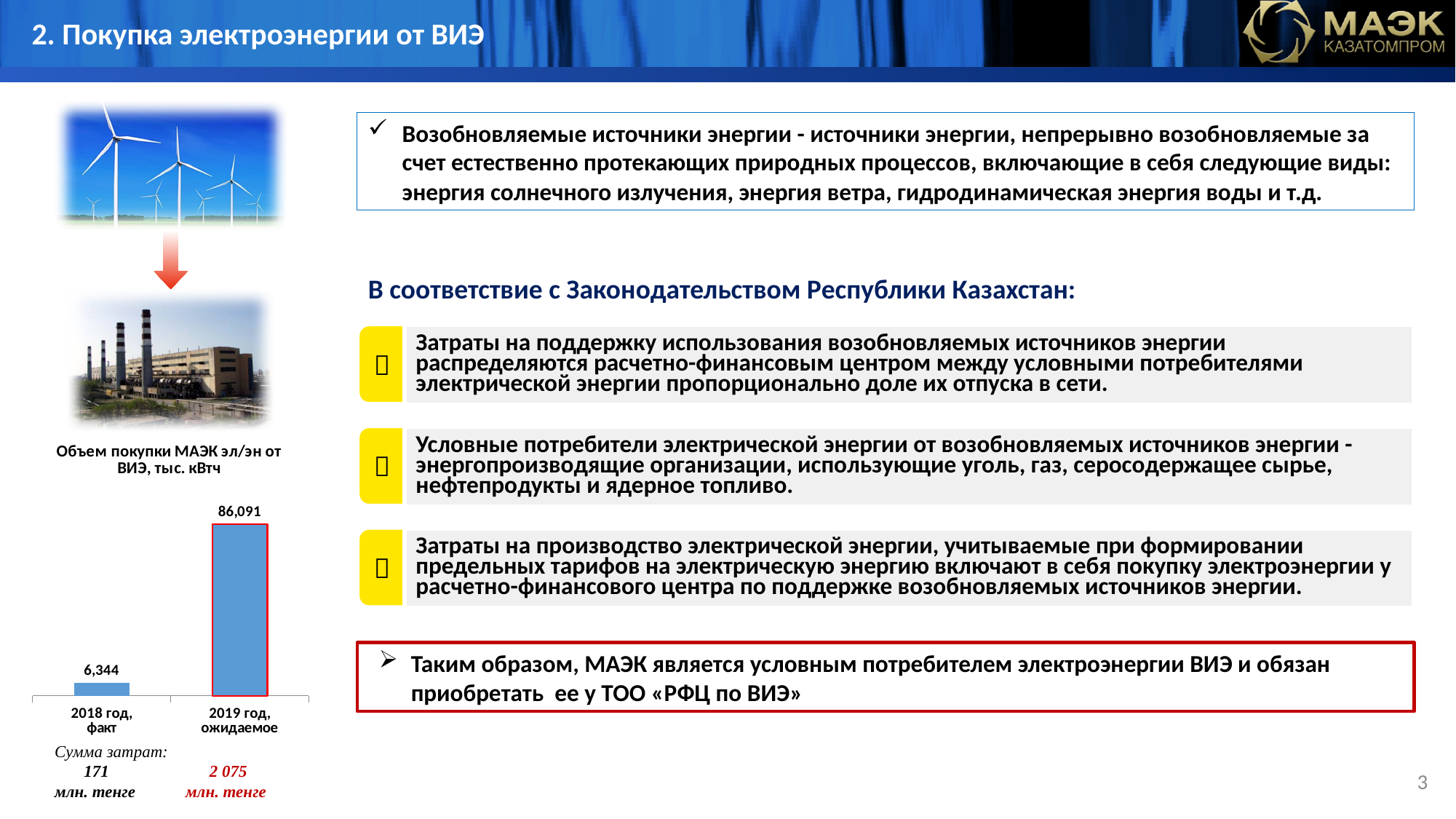
What kind of chart is shown on the slide? bar chart What unit is stated in the chart title? тыс. кВтч Which category has the highest value? 2019 год, ожидаемое What is the difference between the values for 2019 год, ожидаемое and 2018 год, факт? 79,747 What is the value for 2019 год, ожидаемое? 86,091 How many categories are shown in the chart? 2 Which category has the lowest value? 2018 год, факт What is the title of the chart? Объем покупки МАЭК эл/эн от ВИЭ, тыс. кВтч What is the value for 2018 год, факт? 6,344 Do the values rise or fall from 2018 год, факт to 2019 год, ожидаемое? rise Which is larger: the value for 2018 год, факт or the value for 2019 год, ожидаемое? 2019 год, ожидаемое